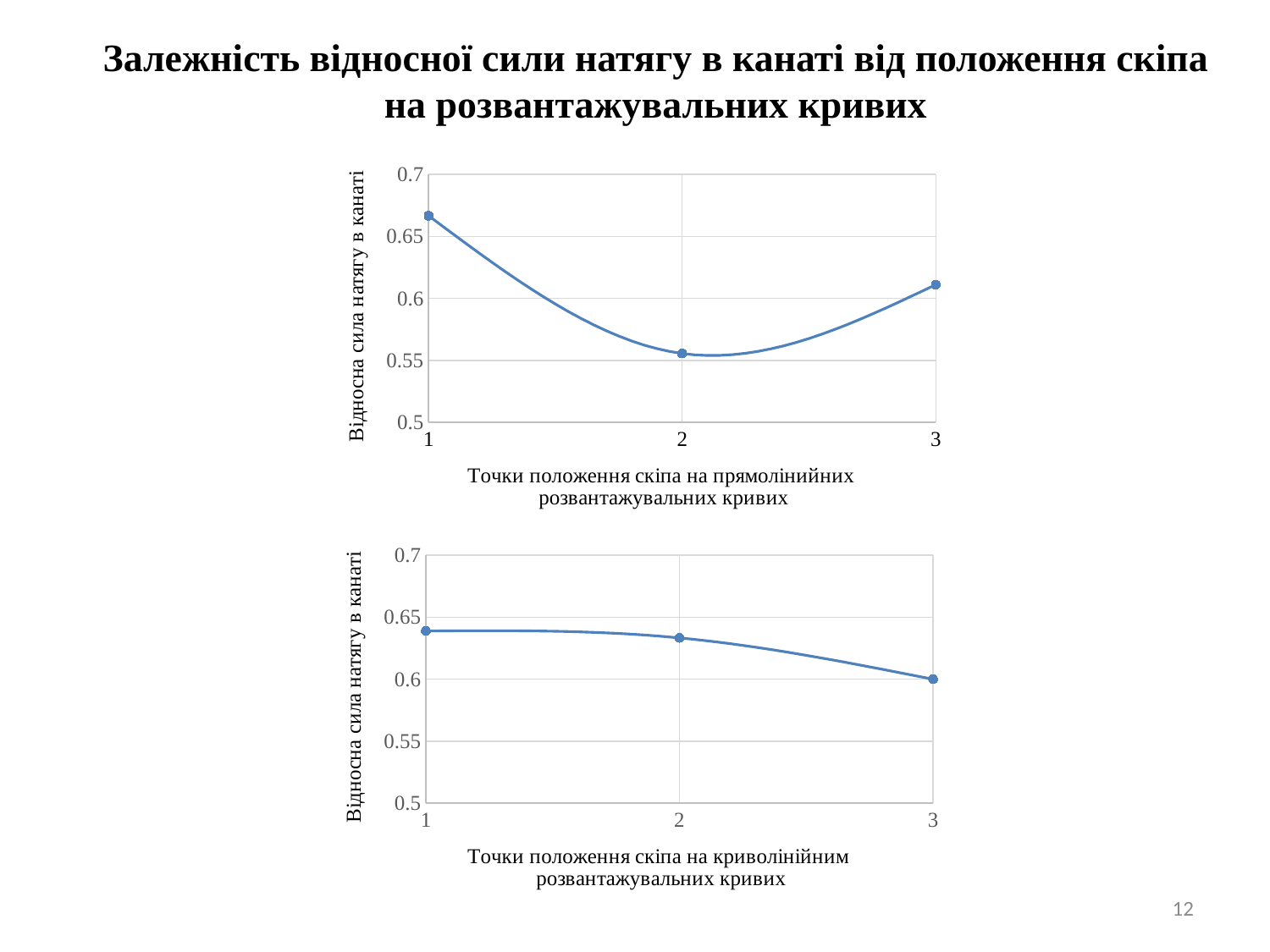
In the bottom chart (криволінійним розвантажувальних кривих), is the value at point 2 greater or less than 0.6? greater In the bottom chart (криволінійним розвантажувальних кривих), is the value at point 1 greater or less than 0.65? less In the top chart (прямолінійних розвантажувальних кривих), which is larger, the value at point 1 or at point 3? point 1 In the top chart (прямолінійних розвантажувальних кривих), is the value at point 1 greater or less than 0.65? greater In the top chart (прямолінійних розвантажувальних кривих), at which point is the relative tension force lowest? 2 In the top chart (прямолінійних розвантажувальних кривих), at which point is the relative tension force highest? 1 In the bottom chart (криволінійним розвантажувальних кривих), do the values rise or fall from point 1 to point 3? fall In the top chart (прямолінійних розвантажувальних кривих), what kind of chart is shown? line chart In the bottom chart (криволінійним розвантажувальних кривих), at which point is the relative tension force lowest? 3 What is the label of the vertical axis in the bottom chart? Відносна сила натягу в канаті In the top chart (прямолінійних розвантажувальних кривих), how many data points are plotted? 3